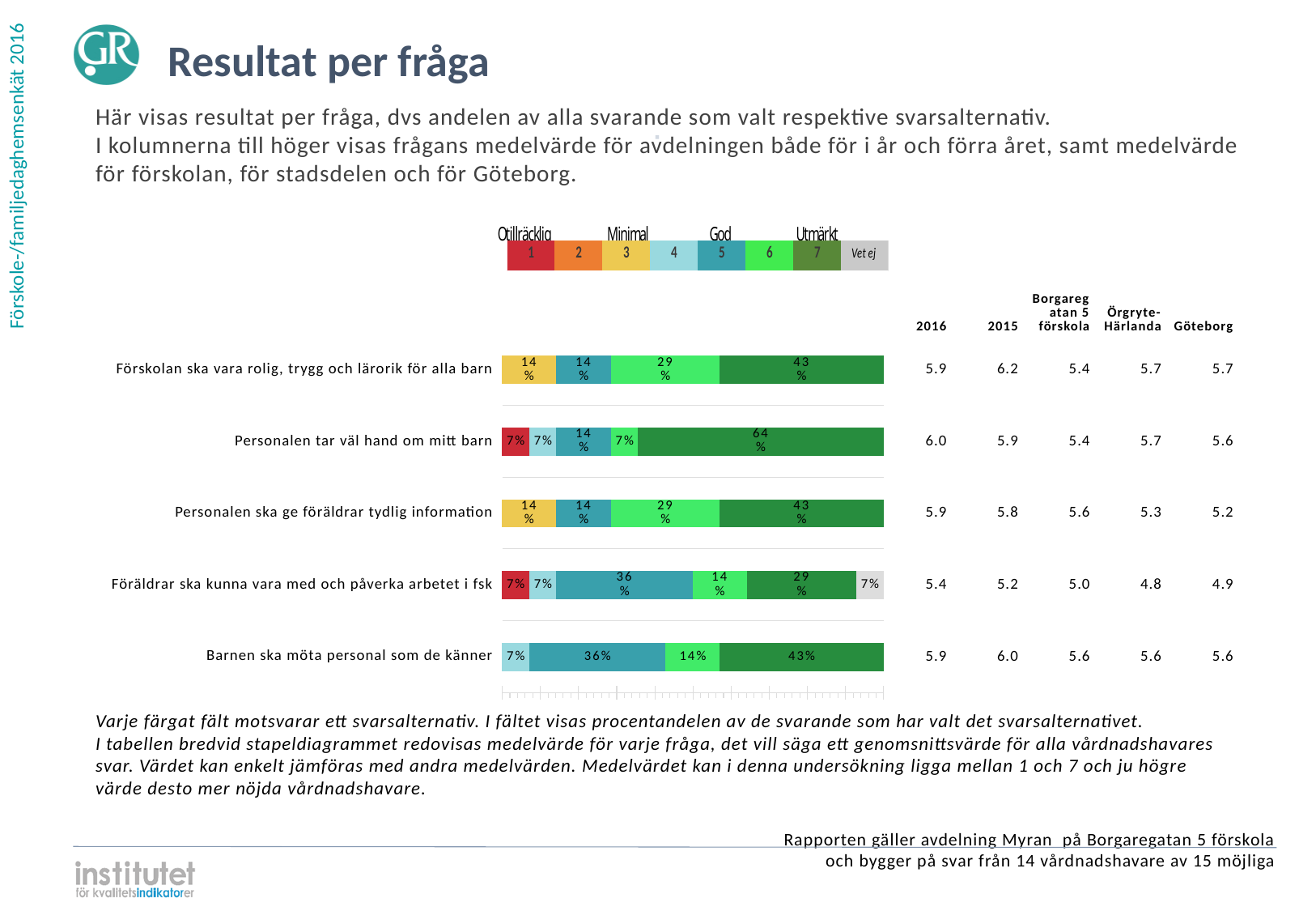
What is the 2016 mean value shown for "Personalen tar väl hand om mitt barn"? 6.0 What share of respondents answered "Vet ej" for "Föräldrar ska kunna vara med och påverka arbetet i fsk"? 7% What share of respondents chose answer 5 for "Barnen ska möta personal som de känner"? 36% How many questions (categories) are shown in the bar chart? 5 Which is larger: the answer 7 share for "Barnen ska möta personal som de känner" or for "Föräldrar ska kunna vara med och påverka arbetet i fsk"? Barnen ska möta personal som de känner What share of respondents chose answer 7 (Utmärkt) for "Personalen tar väl hand om mitt barn"? 64% What is the difference between the answer 7 share for "Personalen tar väl hand om mitt barn" (64%) and for "Förskolan ska vara rolig, trygg och lärorik för alla barn" (43%)? 21% What is the total of the segments in the bar for "Förskolan ska vara rolig, trygg och lärorik för alla barn"? 100% Which question has the largest single segment in its bar? Personalen tar väl hand om mitt barn What kind of chart is used to show the results per question? Stacked bar chart How many answer alternatives does the legend above the chart list? 8 What label does the legend give to answer alternative 7? Utmärkt